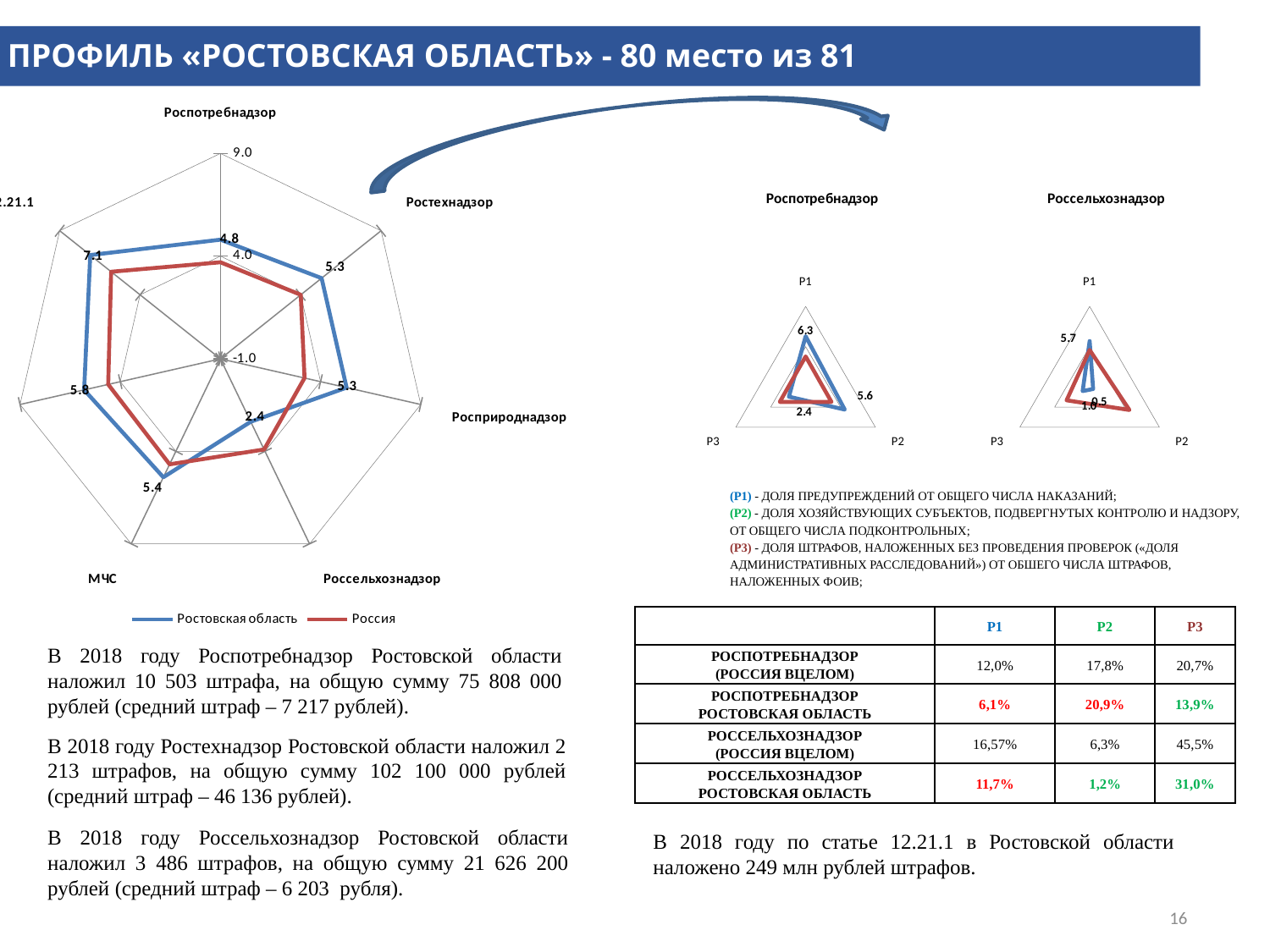
How many series does the legend of the large left chart list? 2 In the large left chart, which series has the larger value on the Роспотребнадзор axis, Ростовская область or Россия? Ростовская область What type of chart is the large chart on the left of the slide? radar chart In the large left chart, what is the value for Ростовская область on the Роспотребнадзор axis? 4.8 In the small Роспотребнадзор chart, which axis has the highest value? P1 In the small Россельхознадзор chart, which axis has the lowest value? P2 In the small Роспотребнадзор chart, what is the difference between the P1 value and the P3 value? 3.9 In the large left chart, what is the value for Ростовская область on the МЧС axis? 5.4 What are the two series named in the legend of the large left chart? Ростовская область, Россия In the large left chart, what is the value for Ростовская область on the Россельхознадзор axis? 2.4